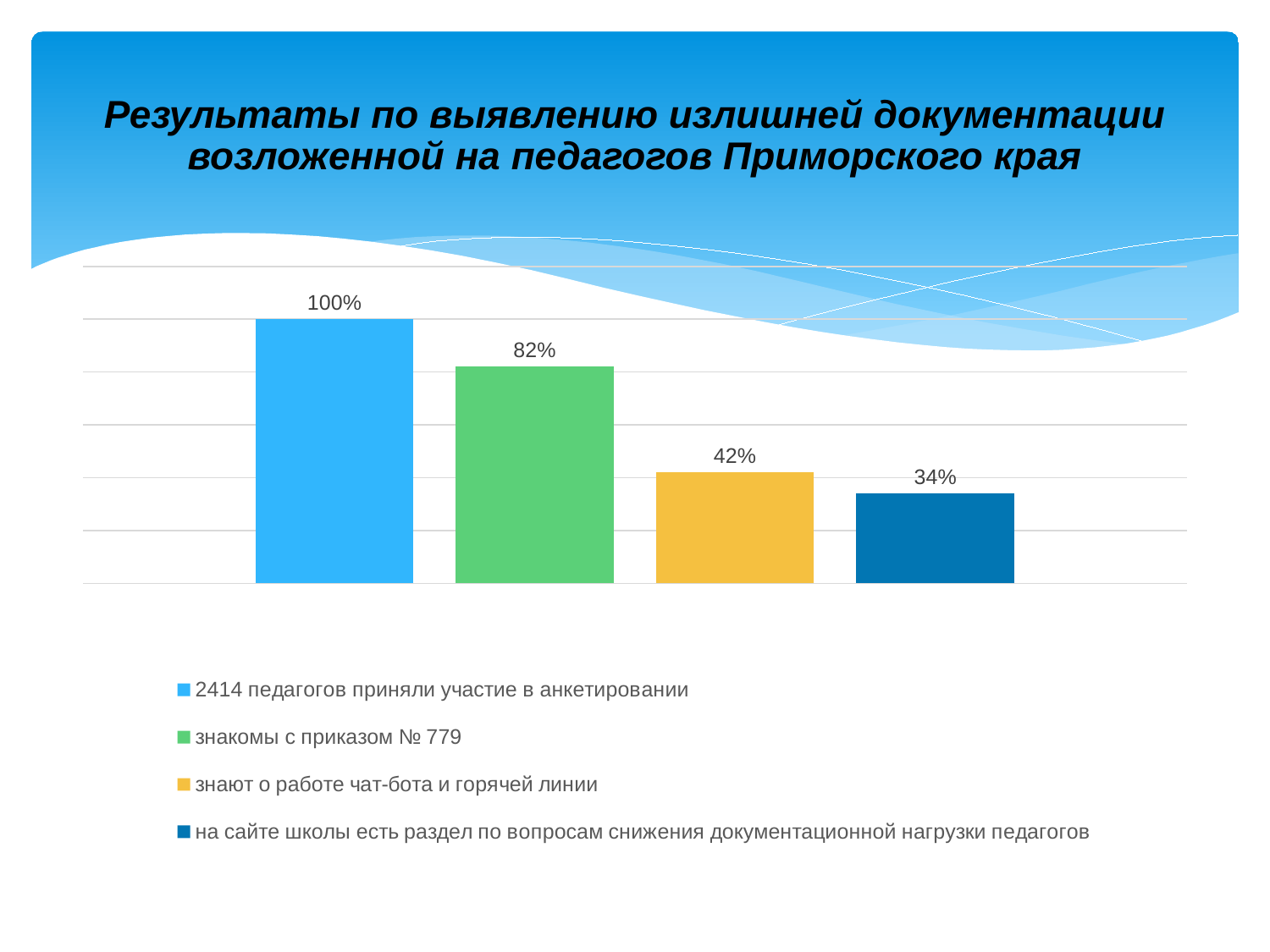
What value is shown for the bar "на сайте школы есть раздел по вопросам снижения документационной нагрузки педагогов"? 34% What is the difference between the value for "знают о работе чат-бота и горячей линии" and the value for "на сайте школы есть раздел по вопросам снижения документационной нагрузки педагогов"? 8% What kind of chart is shown on the slide? Bar chart What value is shown for the bar "знают о работе чат-бота и горячей линии"? 42% Which legend entry has the highest value in the chart? 2414 педагогов приняли участие в анкетировании What value is shown for the bar "2414 педагогов приняли участие в анкетировании"? 100% What value is shown for the bar "знакомы с приказом № 779"? 82% What colour is the bar for "знают о работе чат-бота и горячей линии"? Yellow How many bars are plotted in the chart? 4 Which legend entry has the lowest value in the chart? на сайте школы есть раздел по вопросам снижения документационной нагрузки педагогов Which is larger: the value for "знакомы с приказом № 779" or the value for "знают о работе чат-бота и горячей линии"? знакомы с приказом № 779 What is the difference between the value for "знакомы с приказом № 779" and the value for "знают о работе чат-бота и горячей линии"? 40%